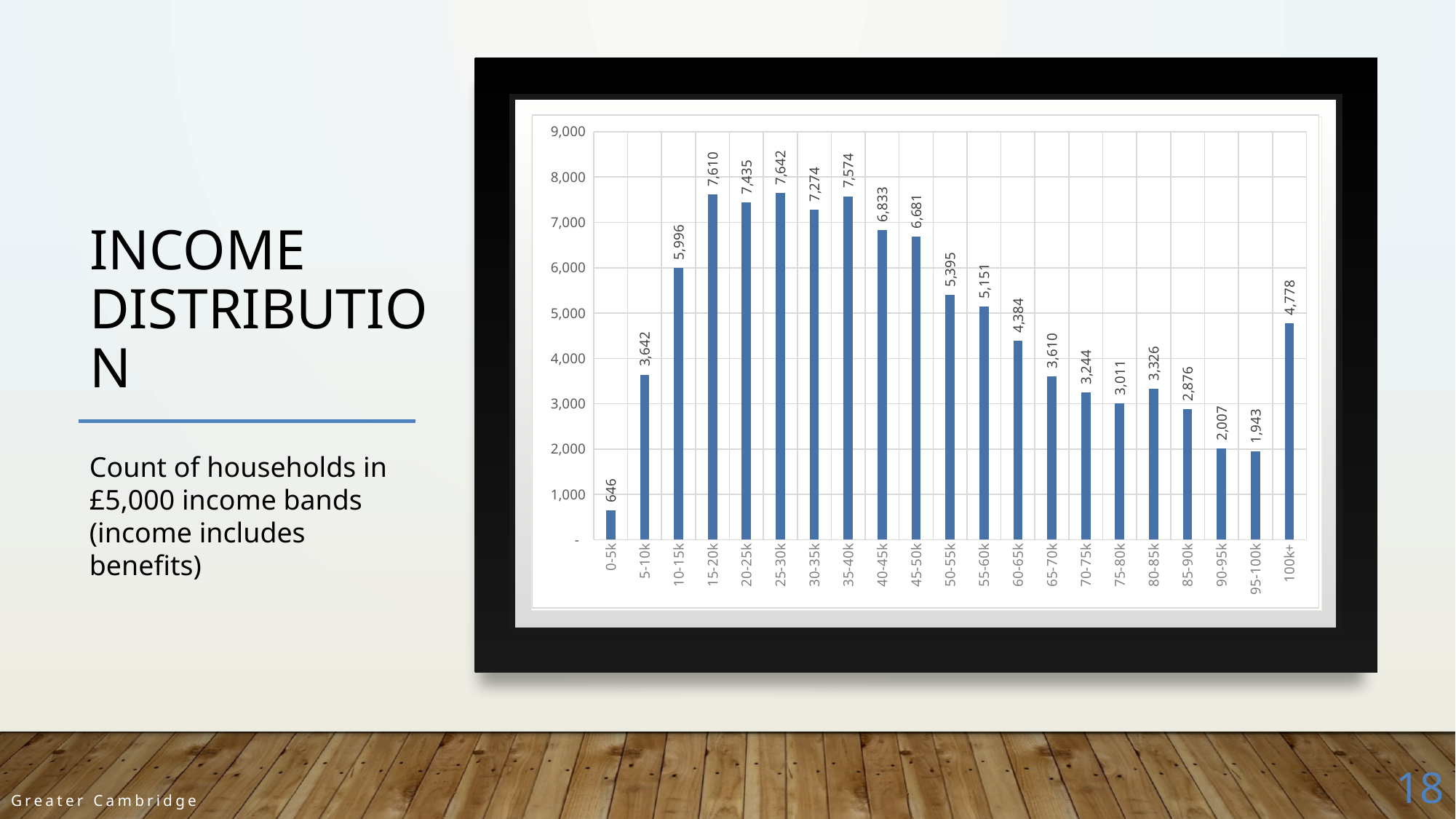
What kind of chart is shown on the slide? Bar chart What is the difference between the 100k+ band and the 95-100k band? 2,835 What is the value shown for the 100k+ band? 4,778 How many income bands are shown on the x axis? 21 Which income band has the lowest count of households? 0-5k Which income band has the highest count of households? 25-30k What is the count of households in the 15-20k income band? 7,610 Is the value for the 60-65k band greater or less than 4,000? greater Which band has more households, 40-45k or 45-50k? 40-45k What is the count of households in the 0-5k band? 646 Do the values rise or fall from the 50-55k band to the 95-100k band? Fall What is the difference between the 15-20k band and the 10-15k band? 1,614